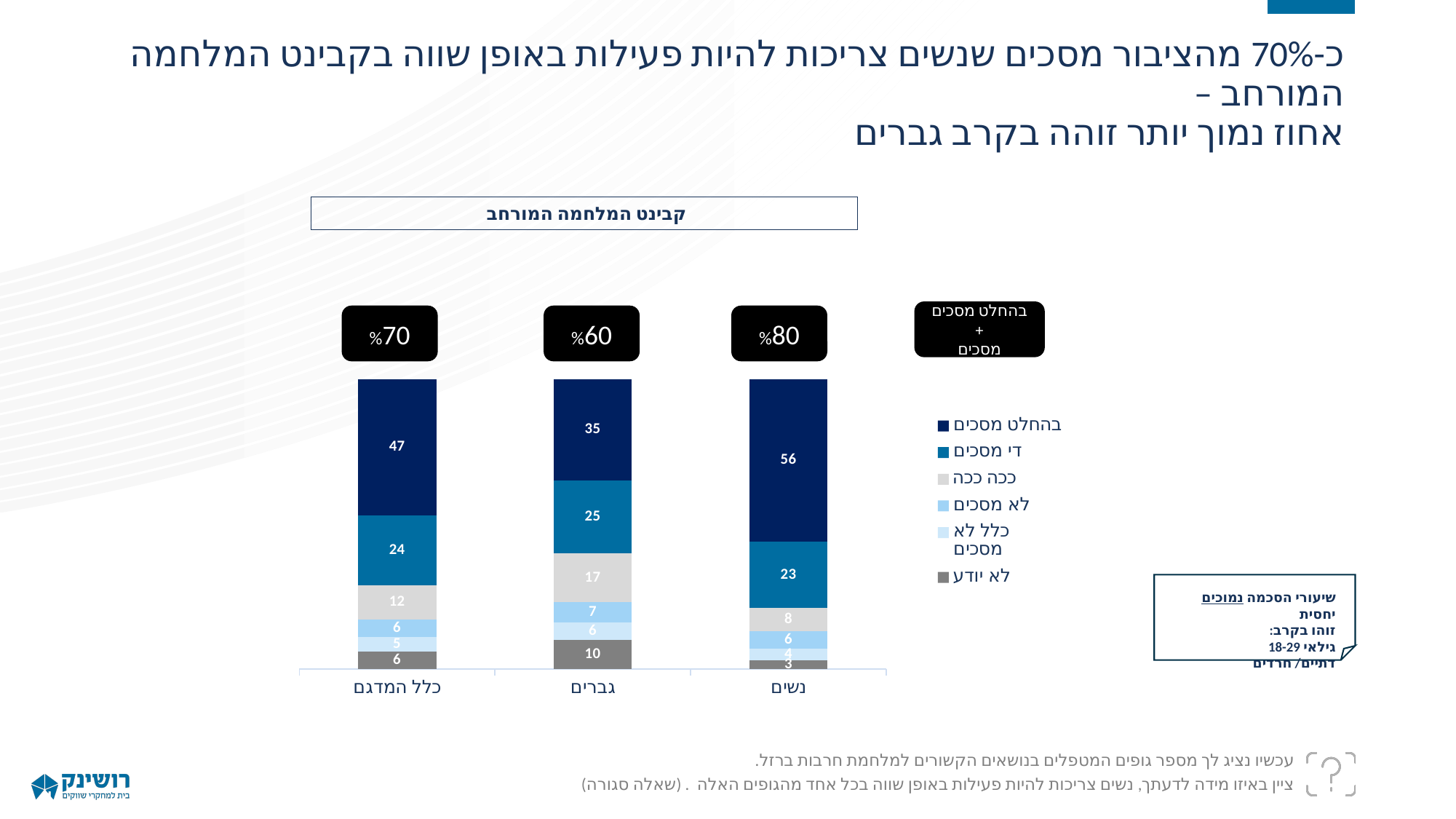
How many series does the chart's legend list? 6 What kind of chart is shown on the slide? stacked bar chart What combined percentage (בהחלט מסכים + מסכים) is shown in the black box above the גברים bar? 60% Which category has the highest value for בהחלט מסכים? נשים Which category has the lowest value for לא יודע? נשים How many categories are shown on the x axis of the chart? 3 What is the value of לא יודע for כלל המדגם? 6 What is the title shown in the box above the chart? קבינט המלחמה המורחב What is the value of בהחלט מסכים for נשים? 56 Which is larger: the ככה ככה value for גברים or for כלל המדגם? גברים What is the value of די מסכים for גברים? 25 What is the difference between the בהחלט מסכים values for נשים and גברים? 21